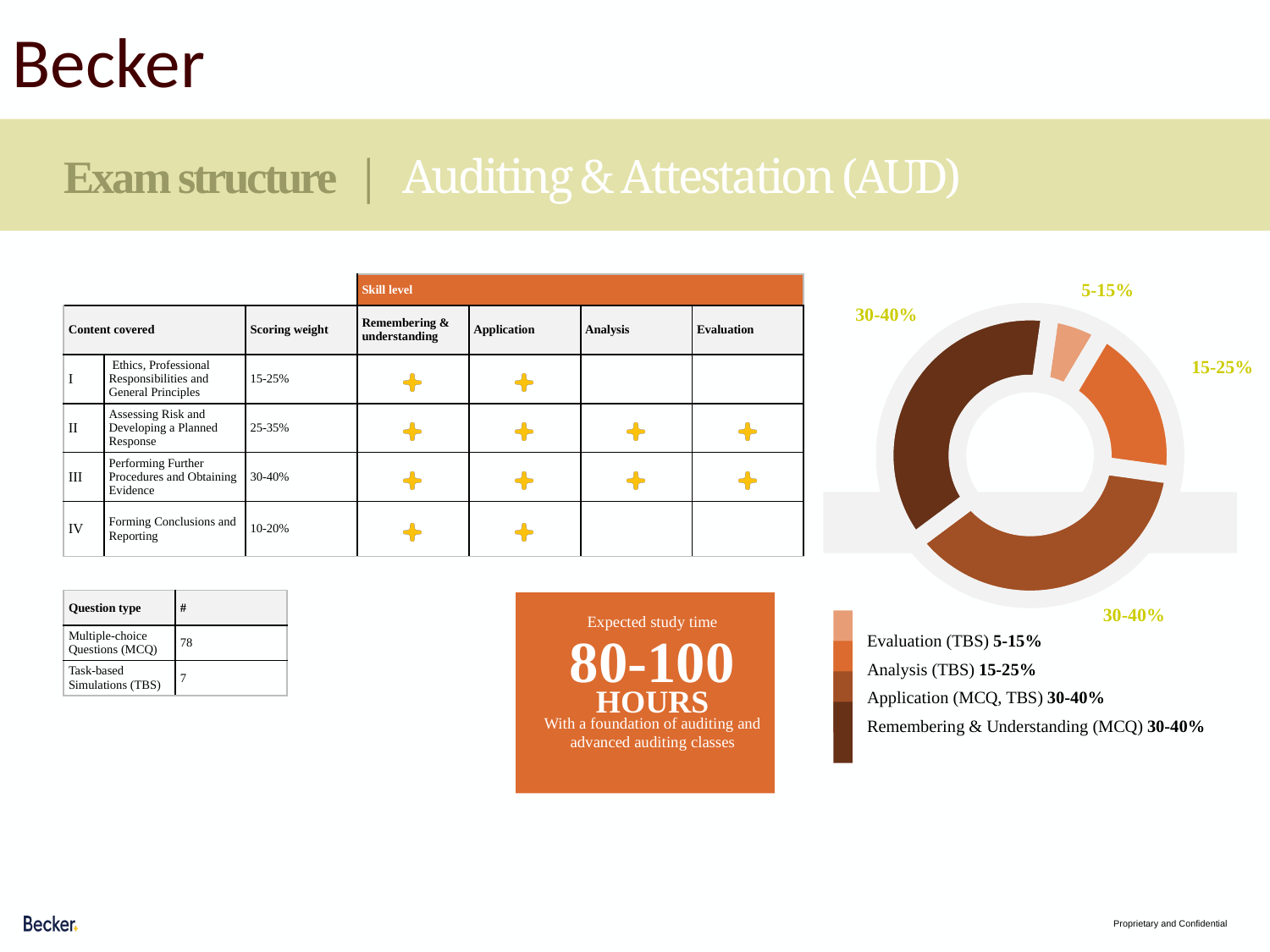
Which skill level has the smallest slice in the donut chart? Evaluation (TBS) What share does the donut chart show for Evaluation (TBS)? 5-15% Which legend entry of the donut chart is shown in the lightest colour? Evaluation (TBS) How many entries does the legend of the donut chart list? 4 Which slice is larger in the donut chart, Analysis (TBS) or Evaluation (TBS)? Analysis (TBS) What share does the donut chart show for Remembering & Understanding (MCQ)? 30-40% Which two skill levels share the same 30-40% weighting in the donut chart? Application (MCQ, TBS) and Remembering & Understanding (MCQ) What kind of chart is shown on the right side of the slide? Pie chart (donut) What share does the donut chart show for Application (MCQ, TBS)? 30-40% How many slices does the donut chart have? 4 What share does the donut chart show for Analysis (TBS)? 15-25%